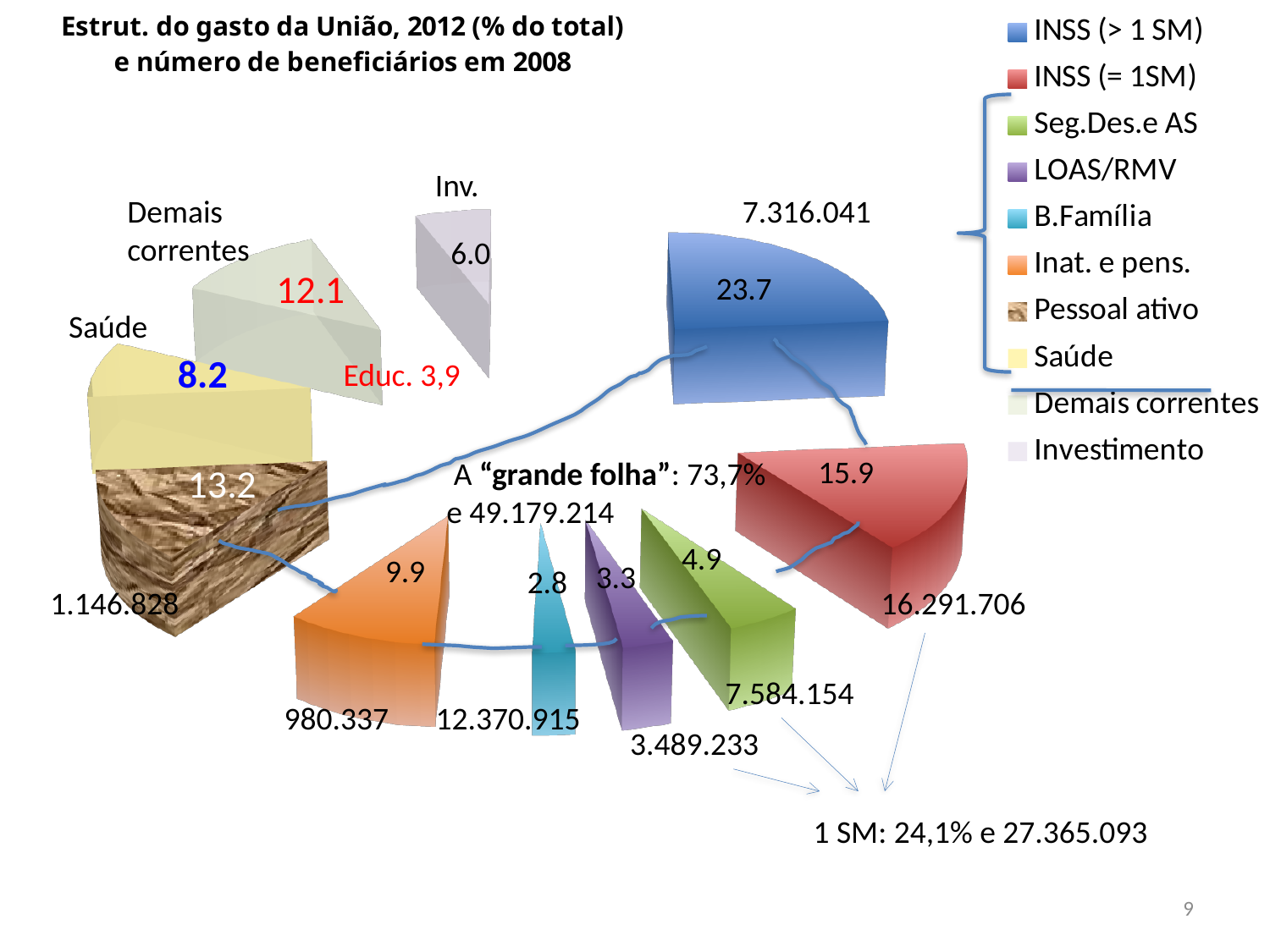
What value is shown for B.Família? 2.8 Which category has the largest share of the pie? INSS (> 1 SM) What percentage of the total is shown for INSS (> 1 SM)? 23.7 What value is shown for Pessoal ativo? 13.2 What kind of chart is shown on the slide? pie chart What value is shown for Saúde? 8.2 What percentage of the total is shown for INSS (= 1SM)? 15.9 Which is larger, the value for Demais correntes or the value for Inat. e pens.? Demais correntes How many entries does the legend list? 10 What is the difference between the values for INSS (> 1 SM) and INSS (= 1SM)? 7.8 Which category has the smallest share of the pie? B.Família What is the title of the chart? Estrut. do gasto da União, 2012 (% do total) e número de beneficiários em 2008